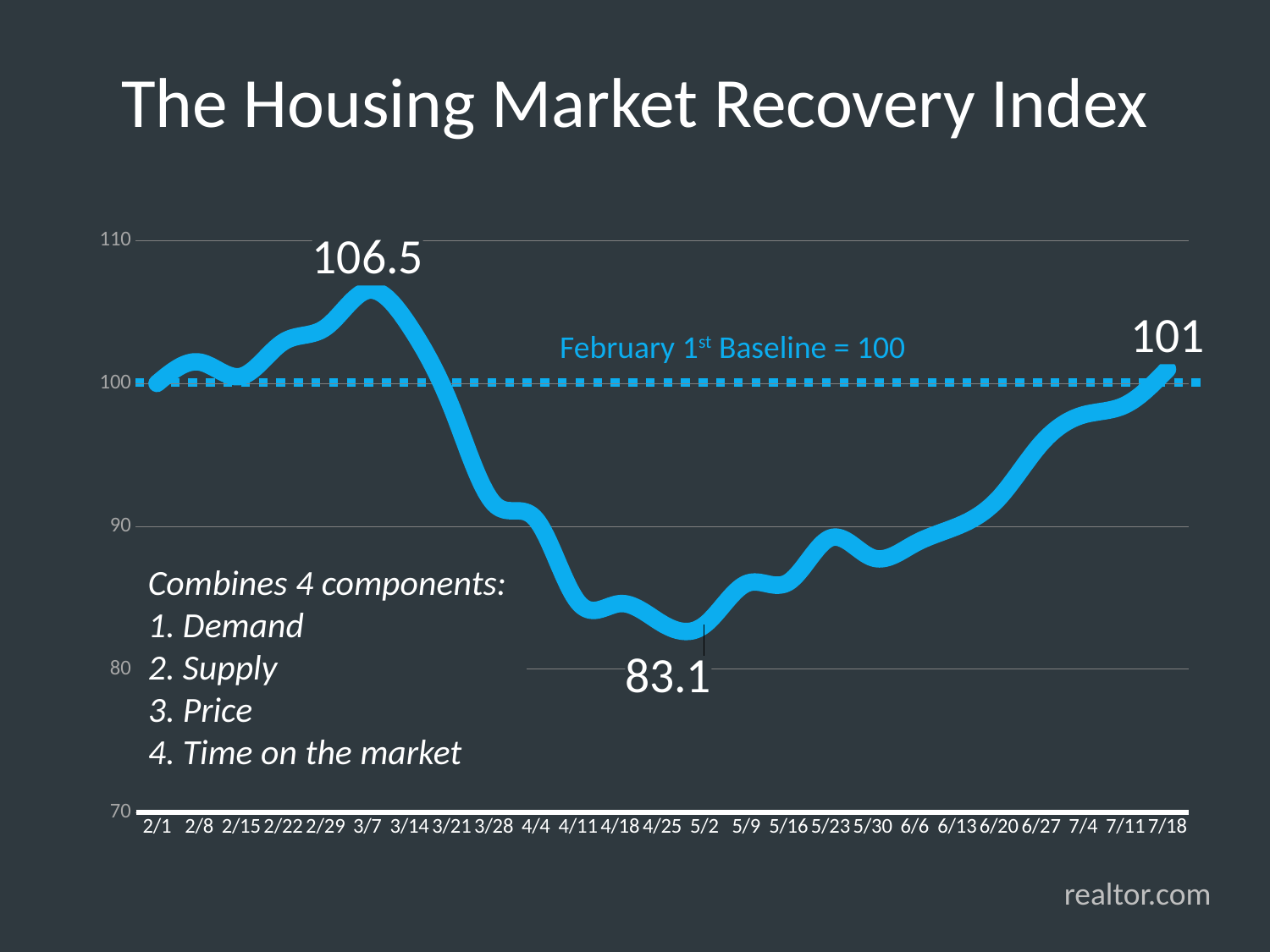
What is the lowest value labelled on the Housing Market Recovery Index line? 83.1 How much higher is the peak value of 106.5 than the final value of 101? 5.5 What kind of chart is shown on the slide? line chart On which date does the index reach its highest value? 3/7 On which date does the index reach its lowest value? 5/2 What is the highest value labelled on the Housing Market Recovery Index line? 106.5 What is the value of the index at the last point, 7/18? 101 What value does the dashed February 1st baseline represent? 100 How many dates are shown on the x axis? 25 Is the value for 4/18 greater or less than 90? less What is the difference between the peak value of 106.5 and the low of 83.1? 23.4 Is the value for 6/27 greater or less than 100? less